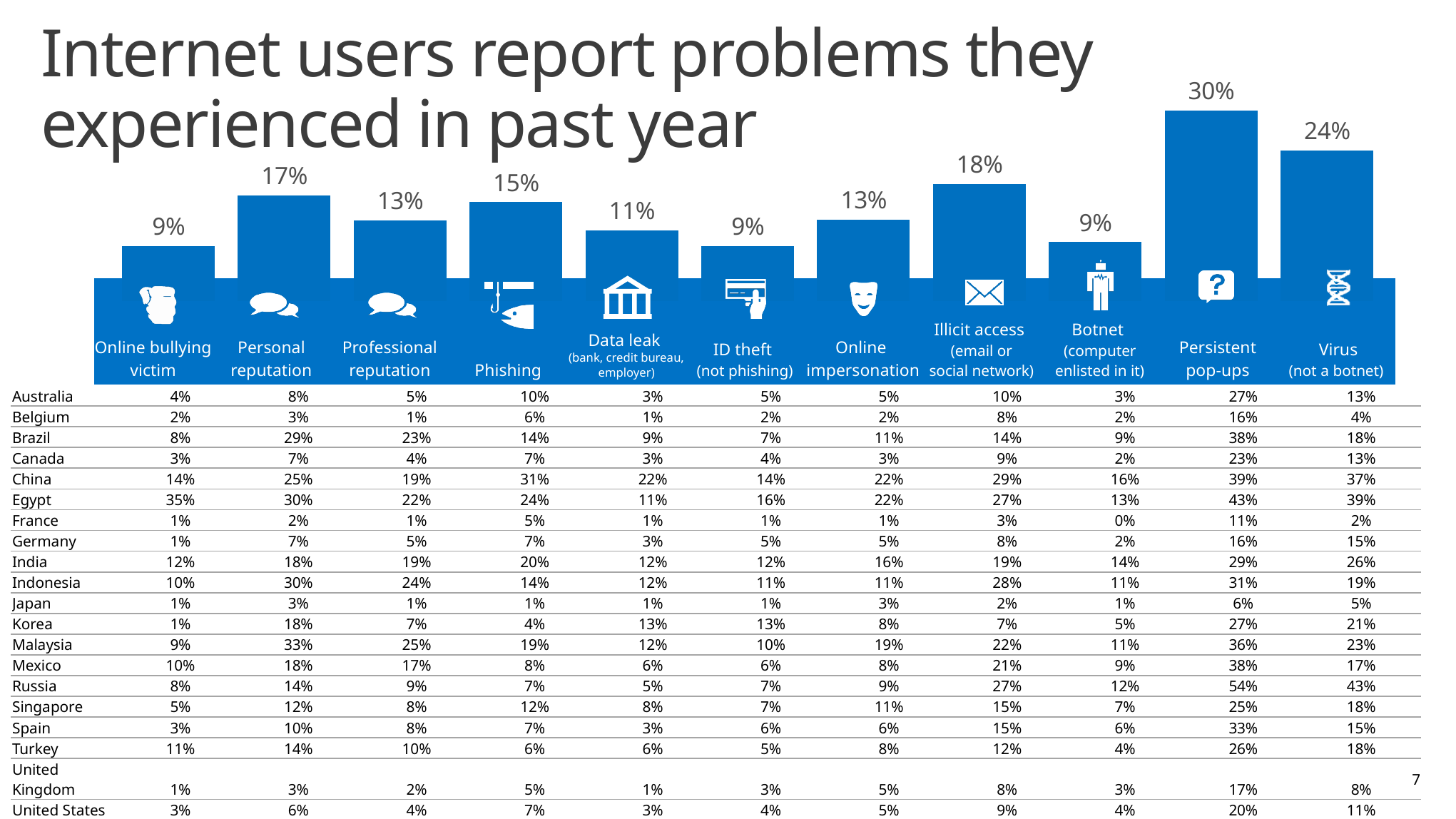
Which category has the highest value in the chart? Persistent pop-ups What value is shown for Data leak (bank, credit bureau, employer)? 11% What value is shown for Virus (not a botnet)? 24% What kind of chart is shown on the slide? Bar chart What value is shown for Phishing? 15% How many categories are plotted in the chart? 11 What value is shown for Illicit access (email or social network)? 18% What is the difference between the values for Persistent pop-ups and Online bullying victim? 21 percentage points What is the difference between the values for Virus (not a botnet) and Phishing? 9 percentage points What value is shown for Persistent pop-ups? 30% Which is larger, the value for Personal reputation or the value for Professional reputation? Personal reputation What is the title of the slide? Internet users report problems they experienced in past year